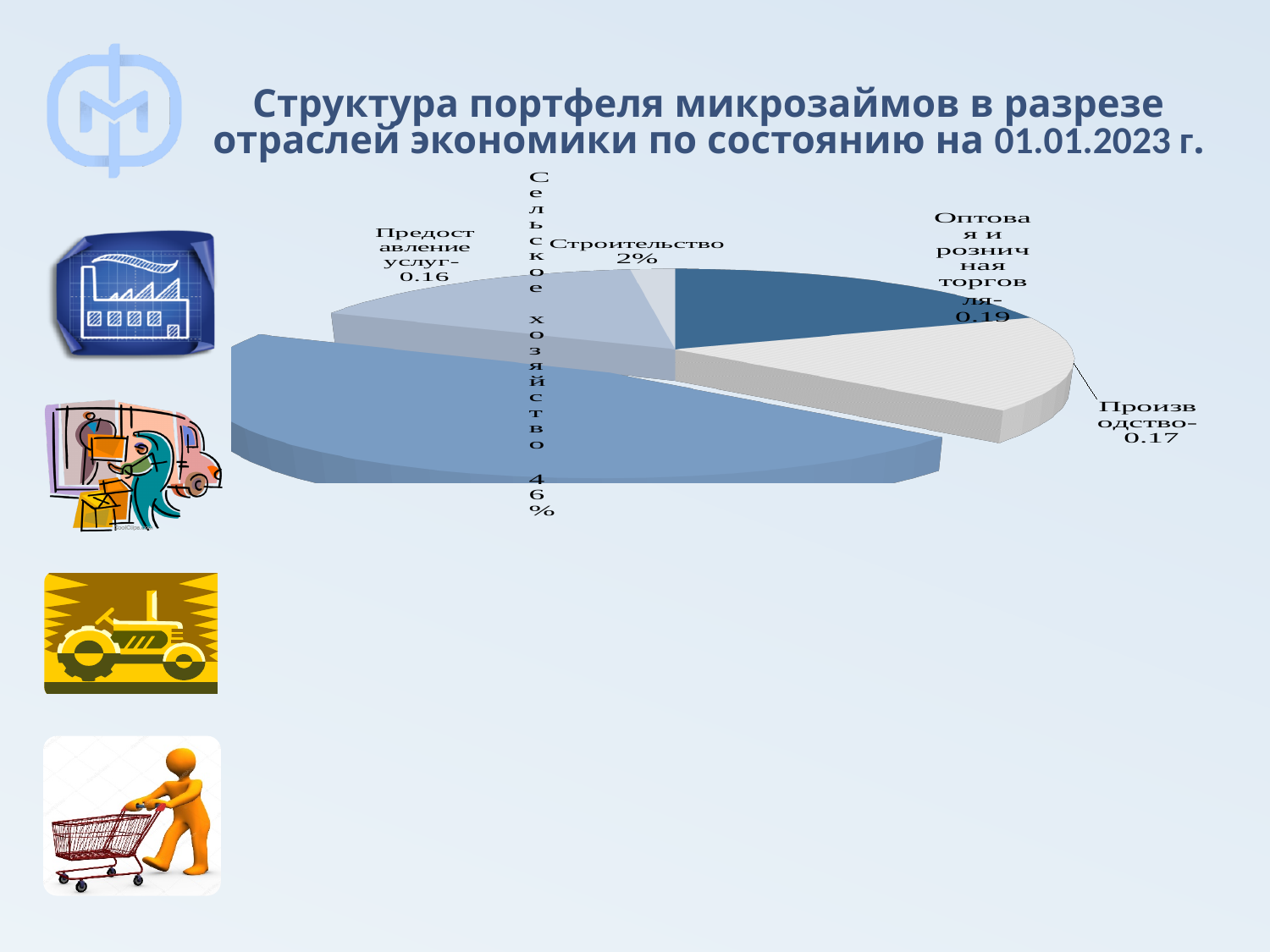
What value is shown for Производство? 0.17 What value is shown for Строительство? 2% What share of the pie does Сельское хозяйство have? 46% What value is shown for Предоставление услуг? 0.16 How many slices does the pie chart have? 5 What value is shown for Оптовая и розничная торговля? 0.19 What kind of chart is shown on the slide? Pie chart Which sector has the largest slice of the pie? Сельское хозяйство Which sector has the smallest slice of the pie? Строительство What is the difference between the values for Оптовая и розничная торговля and Производство? 0.02 Which is larger, the value for Оптовая и розничная торговля or for Производство? Оптовая и розничная торговля As of what date does the slide title say the microloan portfolio structure is shown? 01.01.2023 г.